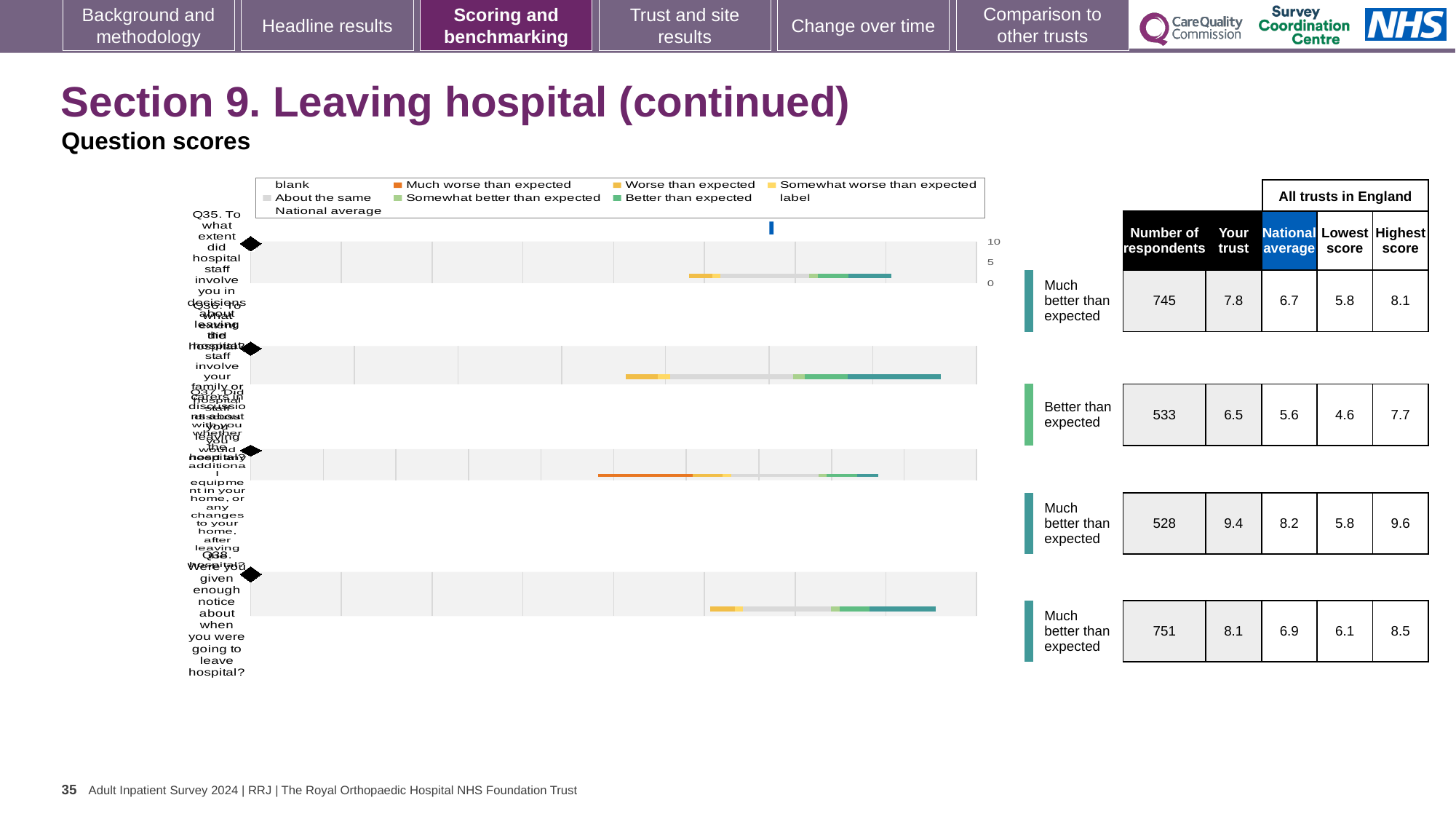
How many questions (rows) are plotted in the chart? 4 What is the lowest score across all trusts in England for Q38 (the last row)? 6.1 How many respondents are shown for Q38 (the last row of the chart)? 751 What heading appears above the 'National average', 'Lowest score' and 'Highest score' columns? All trusts in England What benchmark category is shown for the second row of the chart? Better than expected For Q35 (the first row), what is the difference between the 'Your trust' score and the national average? 1.1 How many rows of the chart are labelled 'Much better than expected'? 3 Which row of the chart has the lowest 'Your trust' score? The second row (6.5) What is the 'Your trust' score for Q35 (the first row of the chart)? 7.8 For the third row of the chart, which is larger: the 'Your trust' score or the highest score in England? Highest score (9.6) What kind of chart is used to show the question scores on this slide? Bar chart Which row of the chart has the highest 'Your trust' score? The third row (9.4)